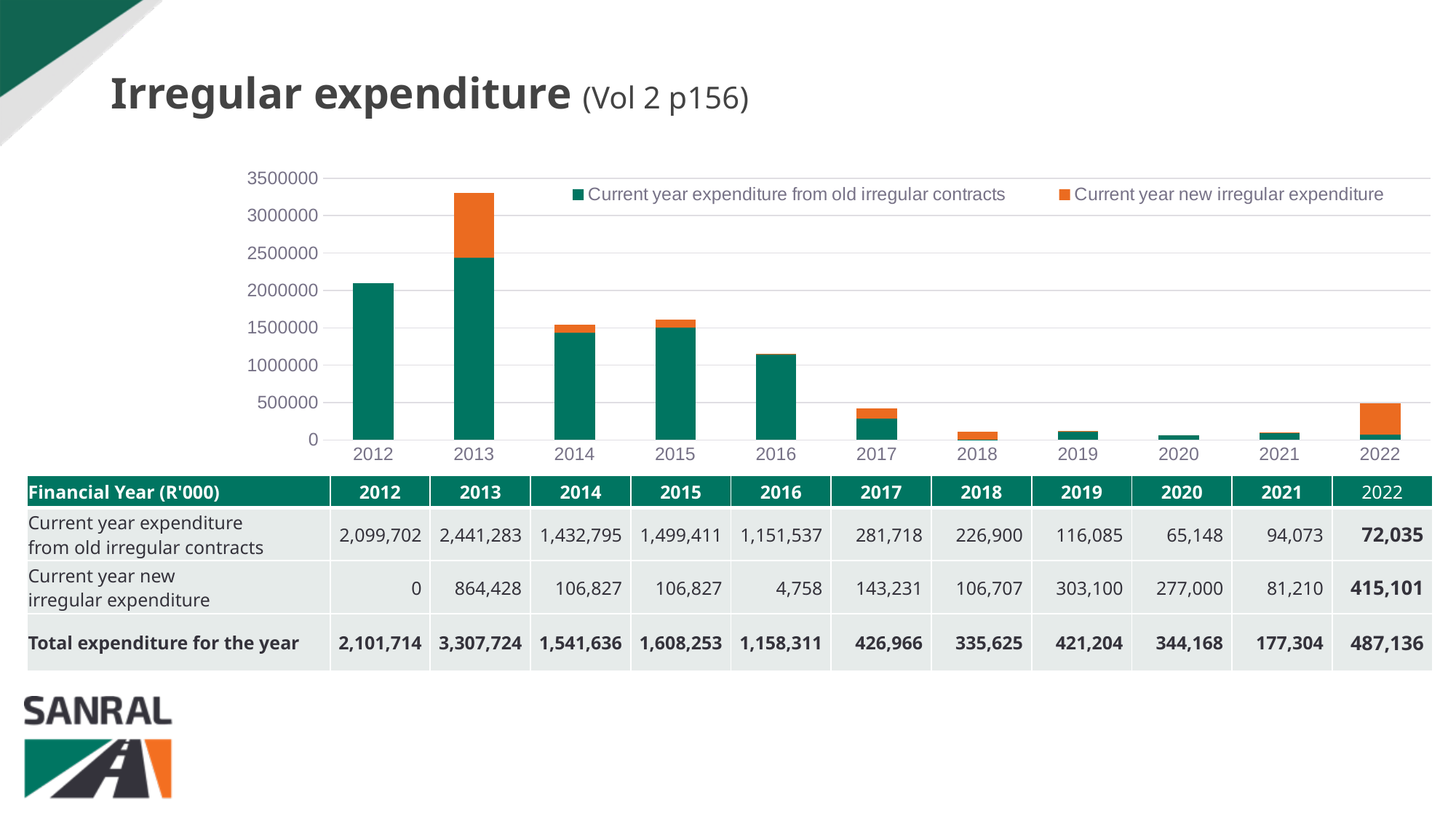
Which year has the lowest total expenditure for the year? 2021 What kind of chart is shown on the slide? Stacked bar chart What is the value of current year new irregular expenditure for 2013? 864,428 What is the total expenditure for the year for 2015? 1,608,253 Which year has the highest total expenditure for the year? 2013 How many financial years are plotted on the x axis of the chart? 11 Is the total height of the 2012 bar greater or less than 2000000? greater Does current year expenditure from old irregular contracts rise or fall from 2012 to 2020? fall Which year has the larger current year new irregular expenditure, 2019 or 2020? 2019 What is the value of current year expenditure from old irregular contracts for 2016? 1,151,537 How many series does the chart's legend list? 2 What is the difference between current year new irregular expenditure and current year expenditure from old irregular contracts in 2022? 343,066